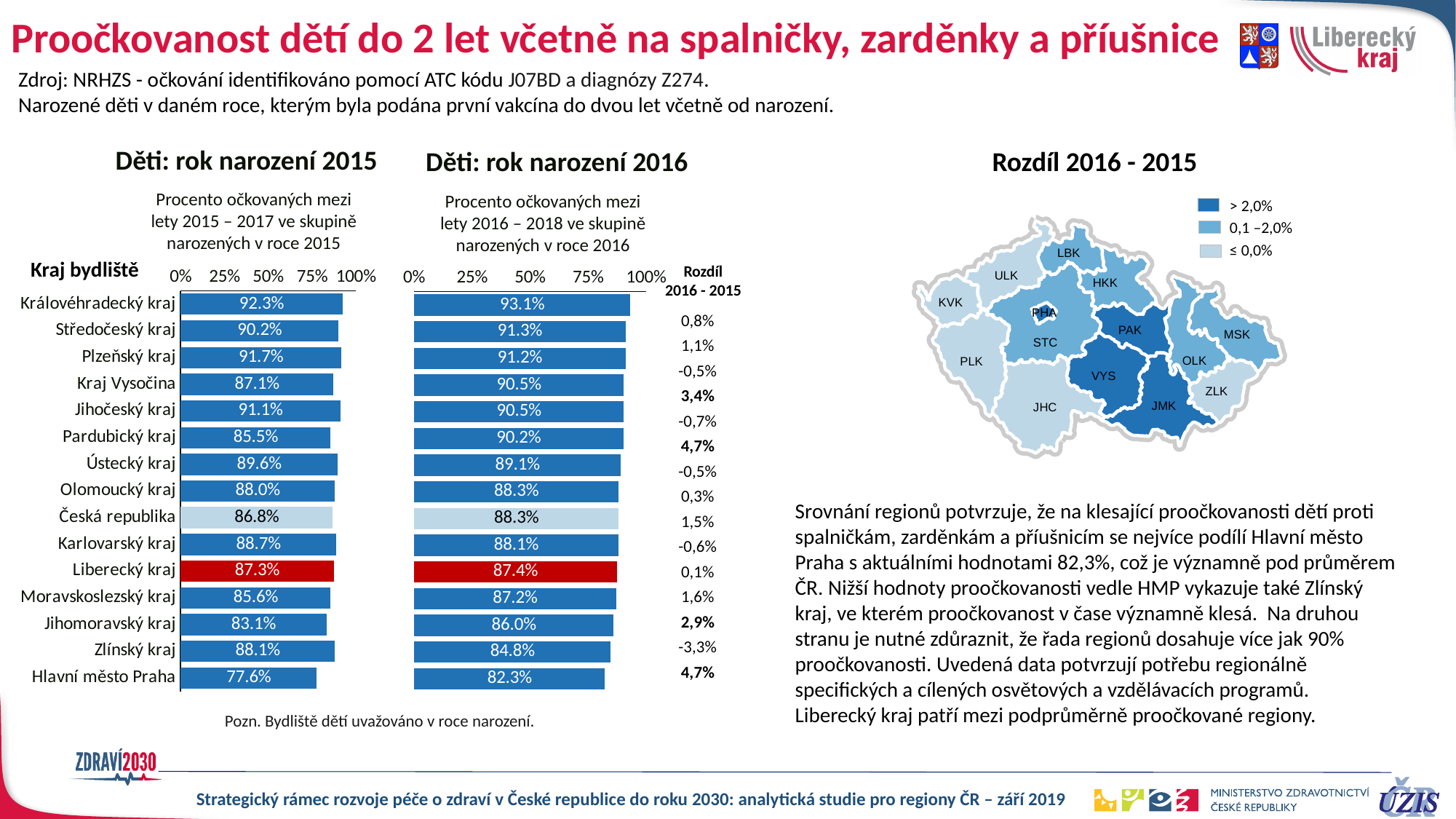
What type of chart is 'Děti: rok narození 2015'? bar chart In the chart 'Děti: rok narození 2015', what is the difference between Liberecký kraj and Česká republika? 0.5% In the chart 'Děti: rok narození 2015', is the value for Hlavní město Praha greater or less than 75%? greater How many bars are shown in the chart 'Děti: rok narození 2016'? 15 In the chart 'Děti: rok narození 2016', what is the value for Česká republika? 88.3% In the chart 'Děti: rok narození 2016', which region has the lowest value? Hlavní město Praha In the chart 'Děti: rok narození 2016', what is the value for Hlavní město Praha? 82.3% In the chart 'Děti: rok narození 2016', which is larger: Zlínský kraj or Jihomoravský kraj? Jihomoravský kraj In the chart 'Děti: rok narození 2015', which region has the highest value? Královéhradecký kraj In the chart 'Děti: rok narození 2015', what is the value for Liberecký kraj? 87.3% In the chart 'Děti: rok narození 2015', which bar is coloured red? Liberecký kraj In the chart 'Děti: rok narození 2015', what is the difference between Královéhradecký kraj and Hlavní město Praha? 14.7%